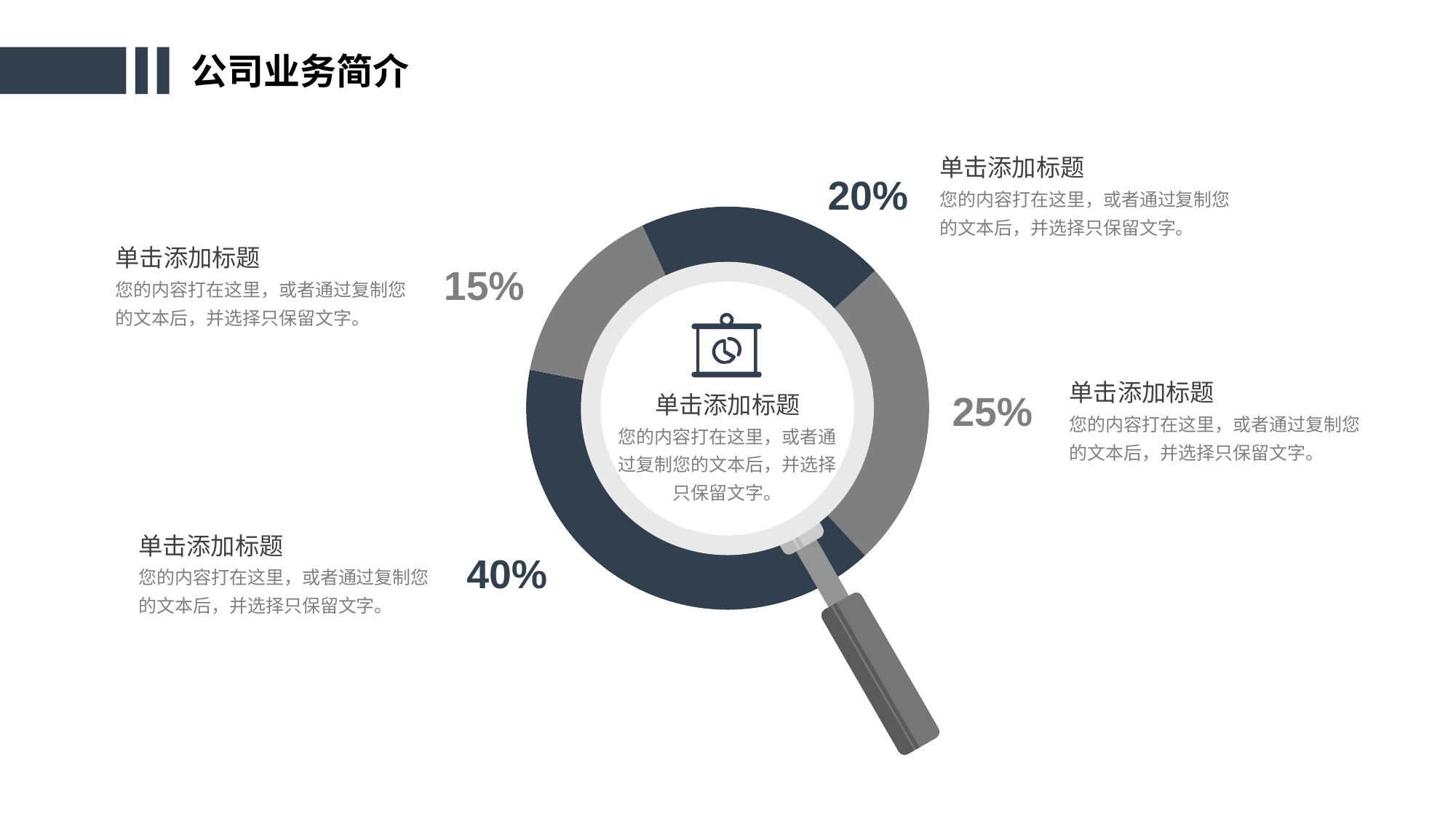
What is the title of the slide containing the chart? 公司业务简介 What is the smallest percentage shown on the ring chart? 15% What percentage is labelled on the segment on the left side of the ring? 15% What kind of chart is shown on the slide? pie chart (donut) What percentage is labelled on the segment at the top of the ring? 20% How many segments does the ring chart have? 4 What do the four segment percentages add up to? 100% Which is larger, the segment on the right of the ring or the segment at the top? the right segment (25%) What is the difference between the largest and smallest segment percentages? 25% What percentage is labelled on the segment on the right side of the ring? 25% What is the largest percentage shown on the ring chart? 40% What percentage is labelled on the large segment at the bottom-left of the ring? 40%